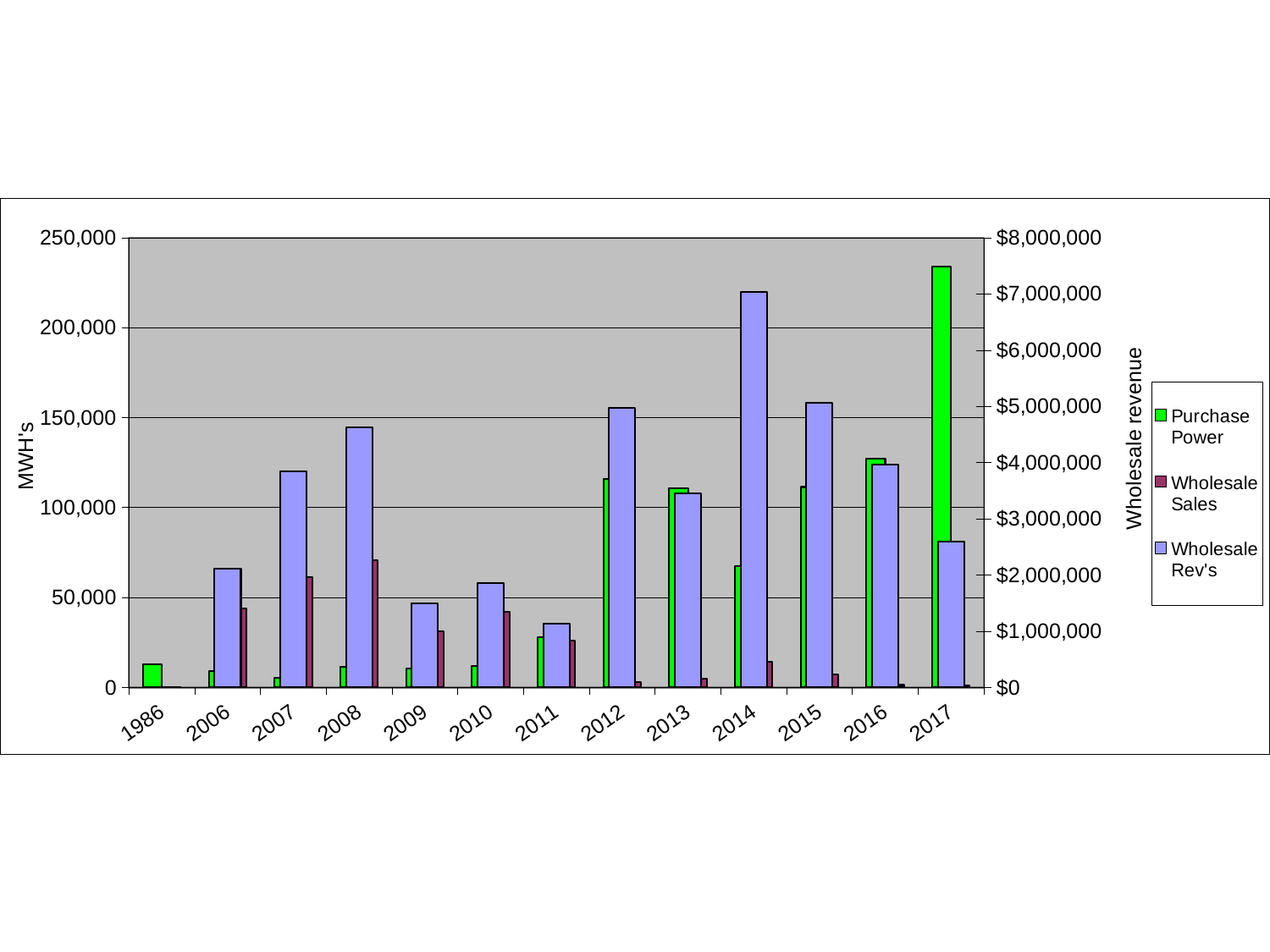
Is the Purchase Power value for 2017 greater or less than 200,000? greater In which year is Wholesale Rev's highest? 2014 In which year is Wholesale Sales highest? 2008 Is the Wholesale Rev's value for 2009 greater or less than $2,000,000? less How many years are shown on the x axis? 13 In which year is Purchase Power highest? 2017 Is the Wholesale Rev's value for 2014 greater or less than $6,000,000? greater Which year has the larger Wholesale Rev's value, 2012 or 2013? 2012 How many series does the legend list? 3 Which year has the larger Wholesale Sales value, 2007 or 2011? 2007 What is the title of the right-hand vertical axis? Wholesale revenue What kind of chart is shown on the slide? bar chart